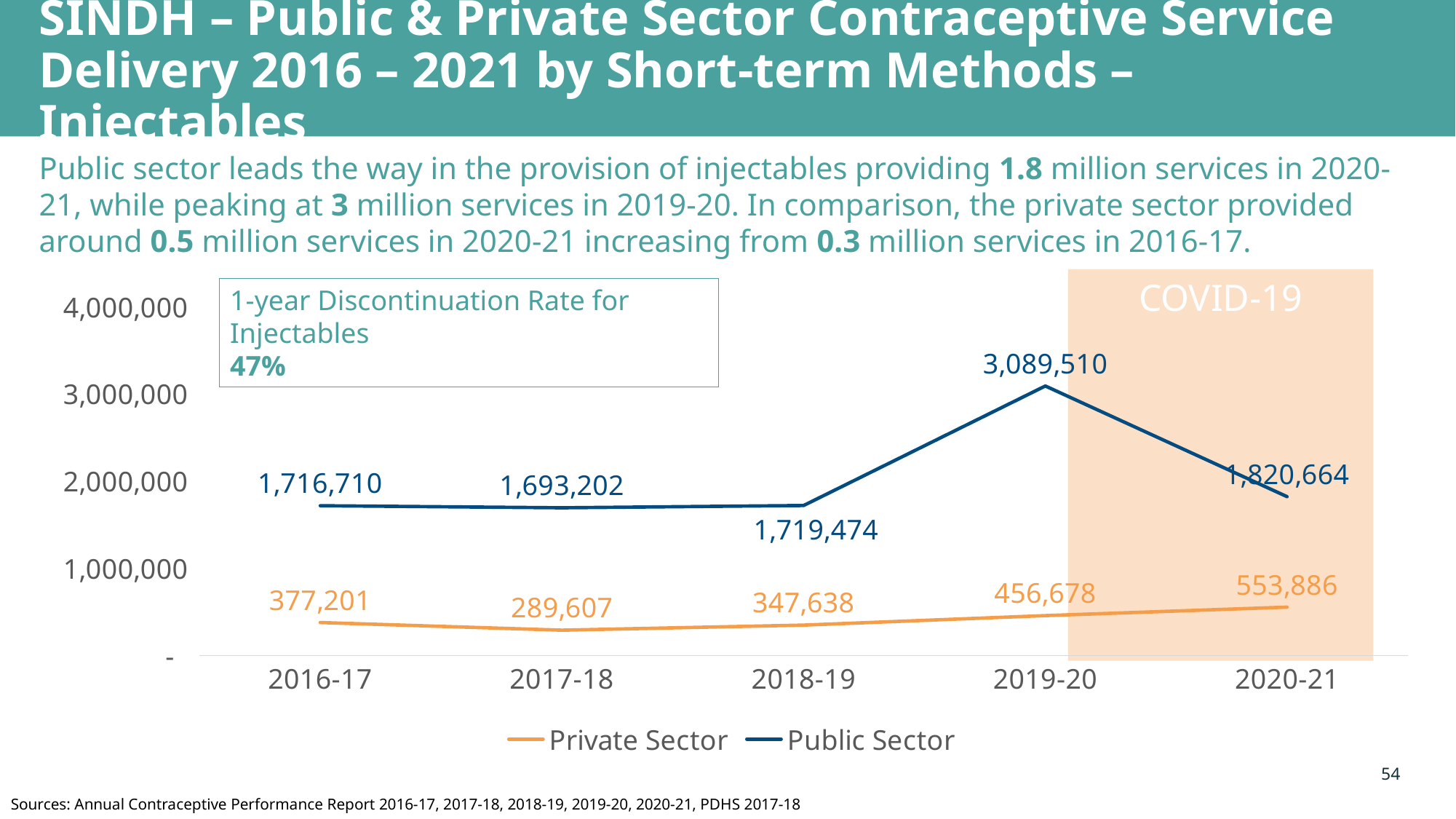
By how much did the Private Sector value increase from 2016-17 to 2020-21? 176,685 What is the difference between the Public Sector and Private Sector values in 2019-20? 2,632,832 What is the Public Sector value for 2019-20? 3,089,510 How many years are plotted on the x axis? 5 What is the Public Sector value for 2020-21? 1,820,664 Is the Public Sector value for 2019-20 greater or less than 3,000,000? greater In which year is the Private Sector value highest? 2020-21 In which year is the Private Sector value lowest? 2017-18 What kind of chart is shown on the slide? line chart Which is larger in 2018-19, the Public Sector value or the Private Sector value? Public Sector What is the Private Sector value for 2017-18? 289,607 In which year is the Public Sector value highest? 2019-20